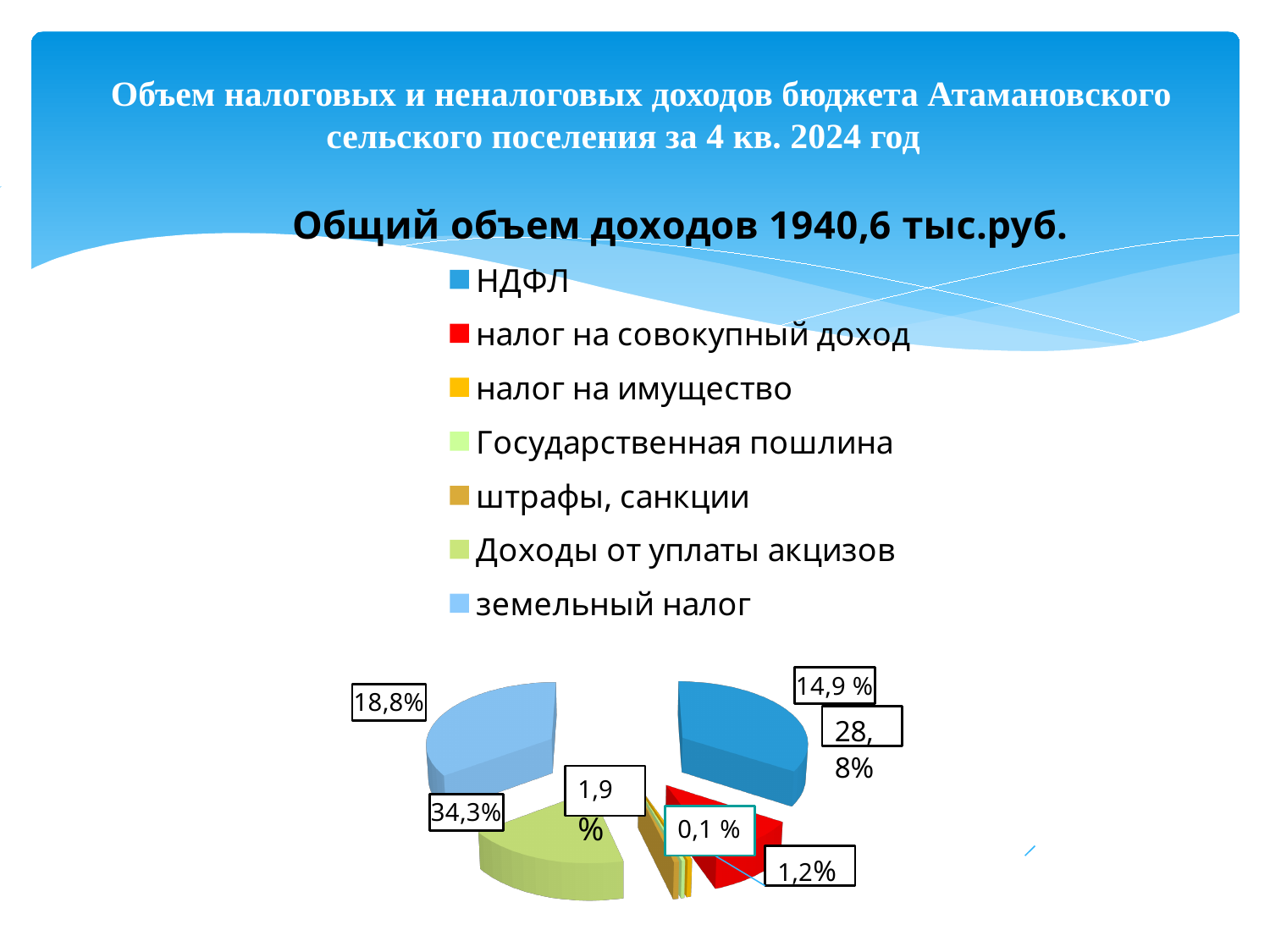
What total revenue amount is stated above the chart? 1940,6 тыс.руб. What colour is the legend marker for земельный налог? light blue How many categories does the legend of the pie chart list? 7 What kind of chart is shown on the slide? pie chart How many slices does the pie chart have? 7 Which is larger: the slice for Доходы от уплаты акцизов or the slice for земельный налог? земельный налог Which is larger: the slice for НДФЛ or the slice for налог на совокупный доход? НДФЛ What is the smallest percentage label shown on the pie chart? 0,1 %